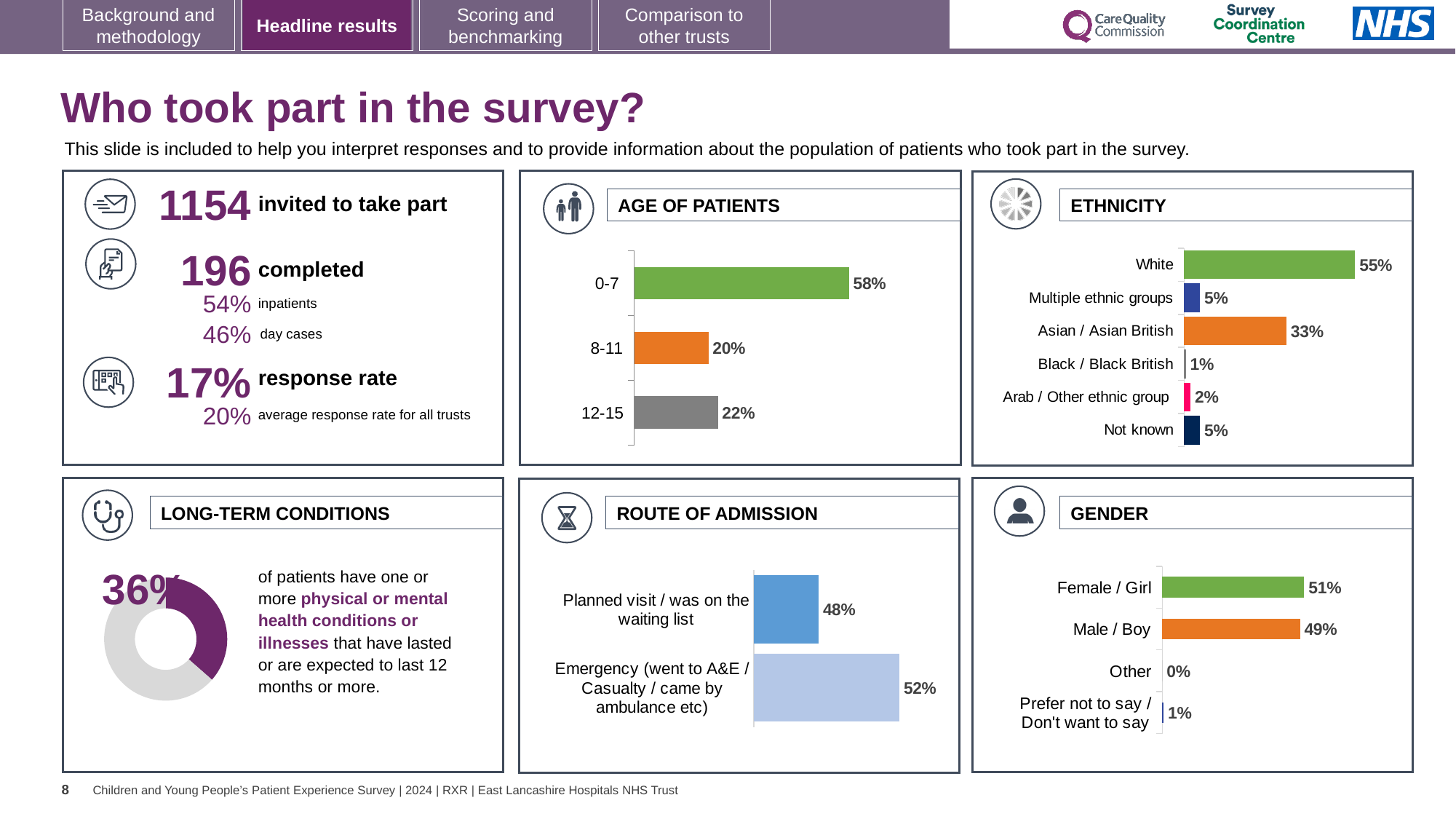
In the LONG-TERM CONDITIONS chart, what share of patients have one or more long-term conditions? 36% In the ETHNICITY chart, what is the value for Asian / Asian British? 33% In the GENDER chart, what is the value for Male / Boy? 49% In the AGE OF PATIENTS chart, what is the value for the 0-7 age group? 58% How many categories are shown in the ETHNICITY chart? 6 In the AGE OF PATIENTS chart, which age group has the lowest value? 8-11 In the GENDER chart, what is the difference between Female / Girl and Male / Boy? 2% In the ETHNICITY chart, which category has the highest value? White In the ROUTE OF ADMISSION chart, what is the value for Emergency (went to A&E / Casualty / came by ambulance etc)? 52% What kind of chart is the LONG-TERM CONDITIONS chart? Donut chart In the ETHNICITY chart, what is the difference between White and Asian / Asian British? 22% In the ROUTE OF ADMISSION chart, which is larger: Planned visit / was on the waiting list or Emergency? Emergency